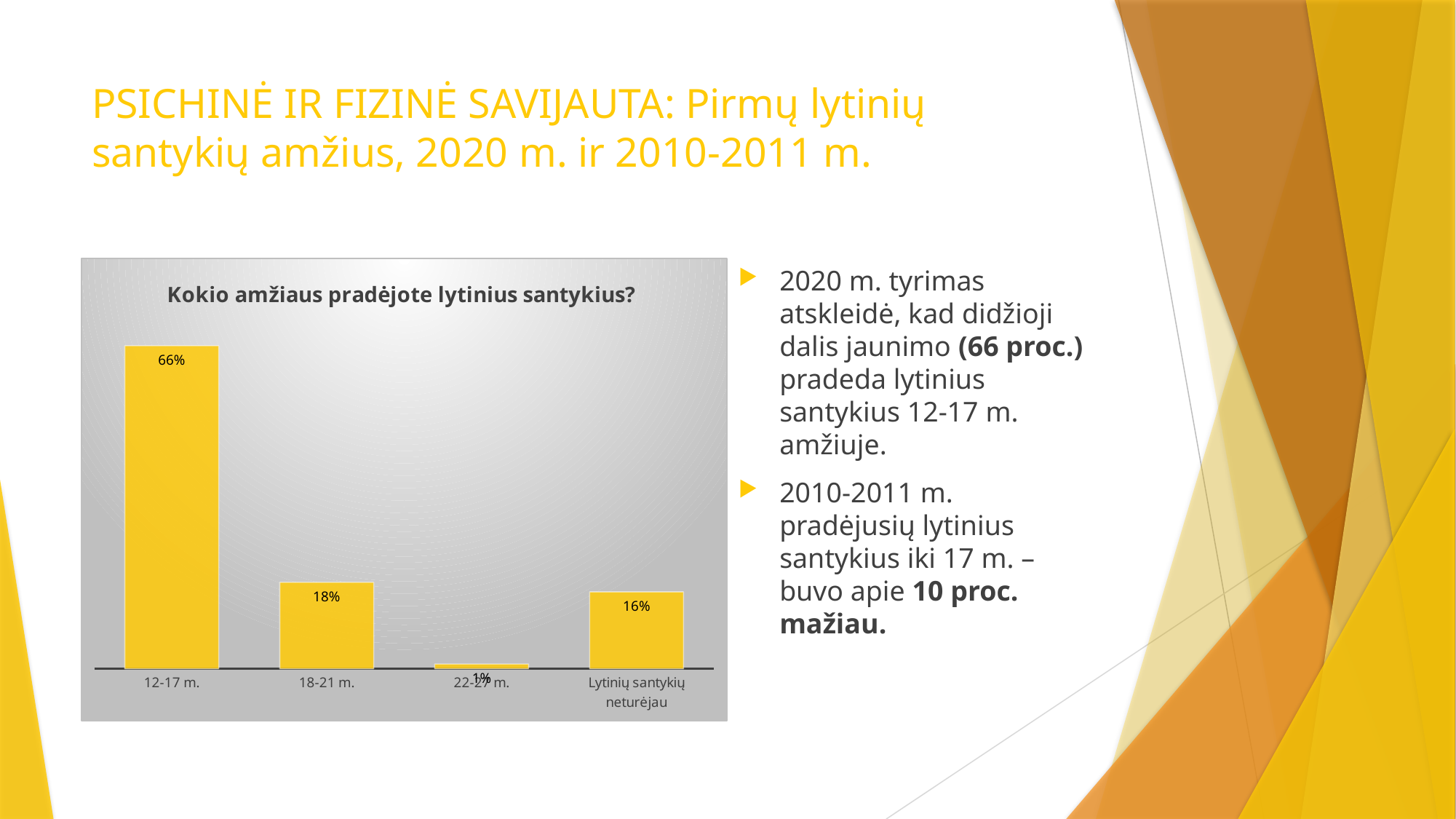
What is the difference between the values for 12-17 m. and 18-21 m.? 48% What is the difference between the values for 12-17 m. and 'Lytinių santykių neturėjau'? 50% What is the title of the chart? Kokio amžiaus pradėjote lytinius santykius? What value is labelled on the third bar from the left? 1% What kind of chart is shown on the slide? Bar chart What percentage is shown for the 'Lytinių santykių neturėjau' category? 16% What is the difference between the values for 18-21 m. and 'Lytinių santykių neturėjau'? 2% How many categories are shown on the chart? 4 What percentage is shown for the 12-17 m. category? 66% What percentage is shown for the 18-21 m. category? 18% Which is larger, the value for 18-21 m. or for 'Lytinių santykių neturėjau'? 18-21 m. Which category has the highest value? 12-17 m.